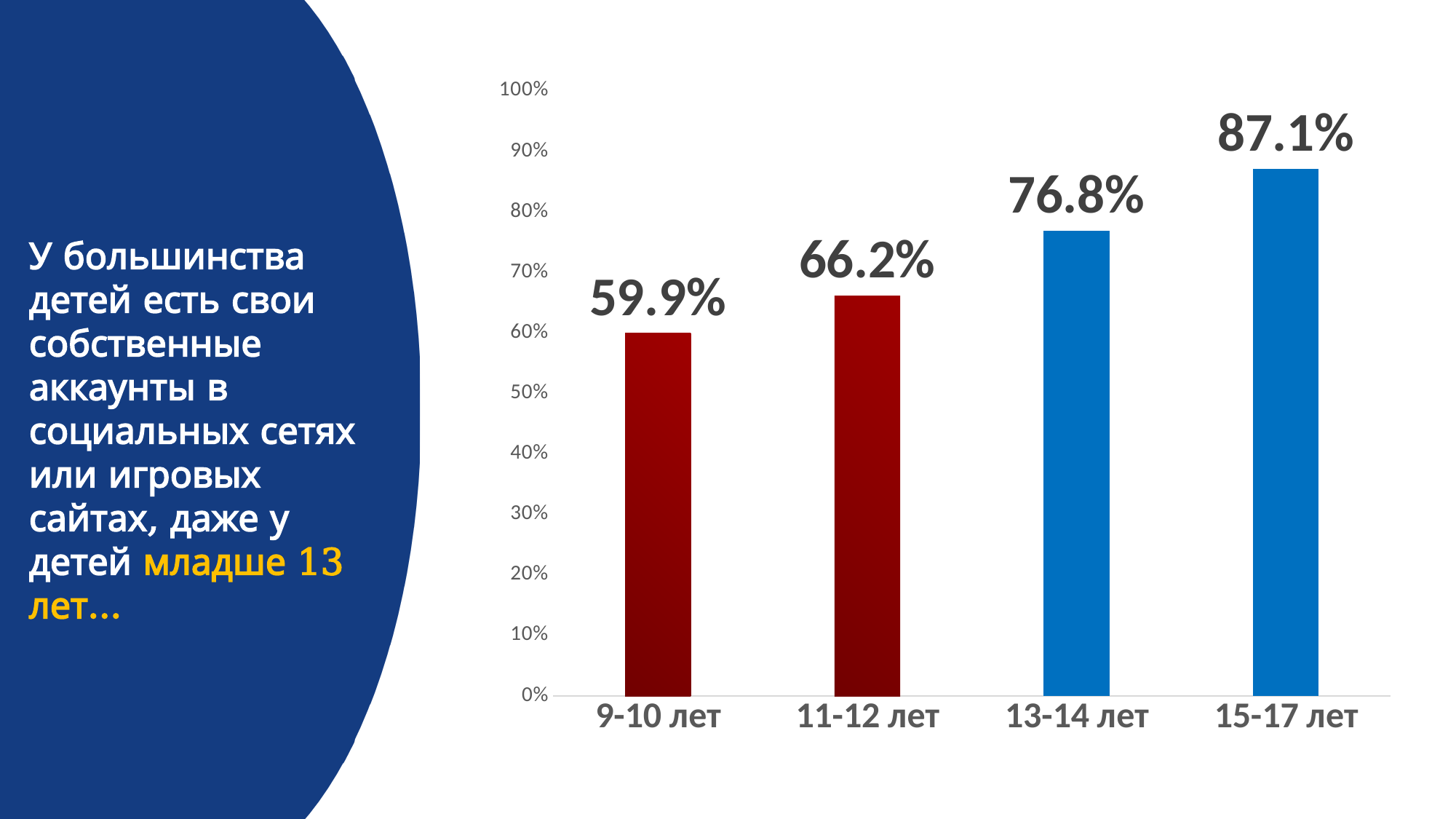
Which is larger, the value for 11-12 лет or the value for 13-14 лет? 13-14 лет What is the value for 9-10 лет? 59.9% Which age group has the lowest value? 9-10 лет What kind of chart is shown on the slide? Bar chart Which age group has the highest value? 15-17 лет What is the value for 11-12 лет? 66.2% What is the value for 15-17 лет? 87.1% What is the difference between the values for 15-17 лет and 9-10 лет? 27.2% What is the difference between the values for 13-14 лет and 11-12 лет? 10.6% How many age groups are shown on the chart? 4 Do the values rise or fall from left to right across the age groups? Rise What is the value for 13-14 лет? 76.8%